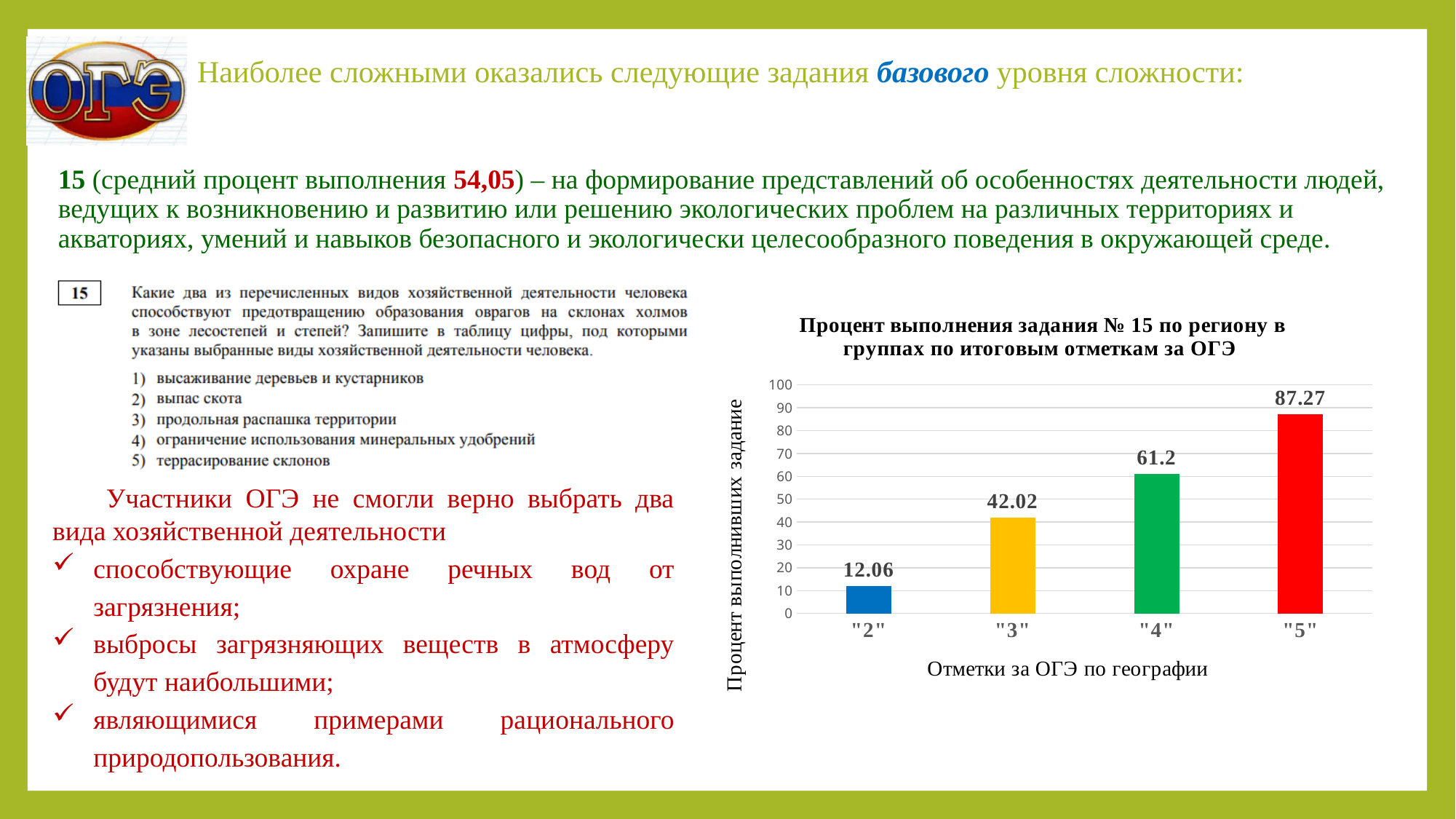
What is the value for the "2" grade group in the chart? 12.06 What is the difference between the values for the "5" and "2" grade groups? 75.21 What kind of chart is shown on the slide? bar chart Which grade group has the highest percentage of completing task 15? "5" What is the value for the "5" grade group in the chart? 87.27 Is the value for the "3" grade group greater or less than 50? less Do the values rise or fall as the grade increases from "2" to "5"? rise Which is larger, the value for the "3" group or the "4" group? "4" What is the value for the "4" grade group in the chart? 61.2 What is the difference between the values for the "4" and "3" grade groups? 19.18 How many grade groups are shown in the chart? 4 Which grade group has the lowest percentage of completing task 15? "2"